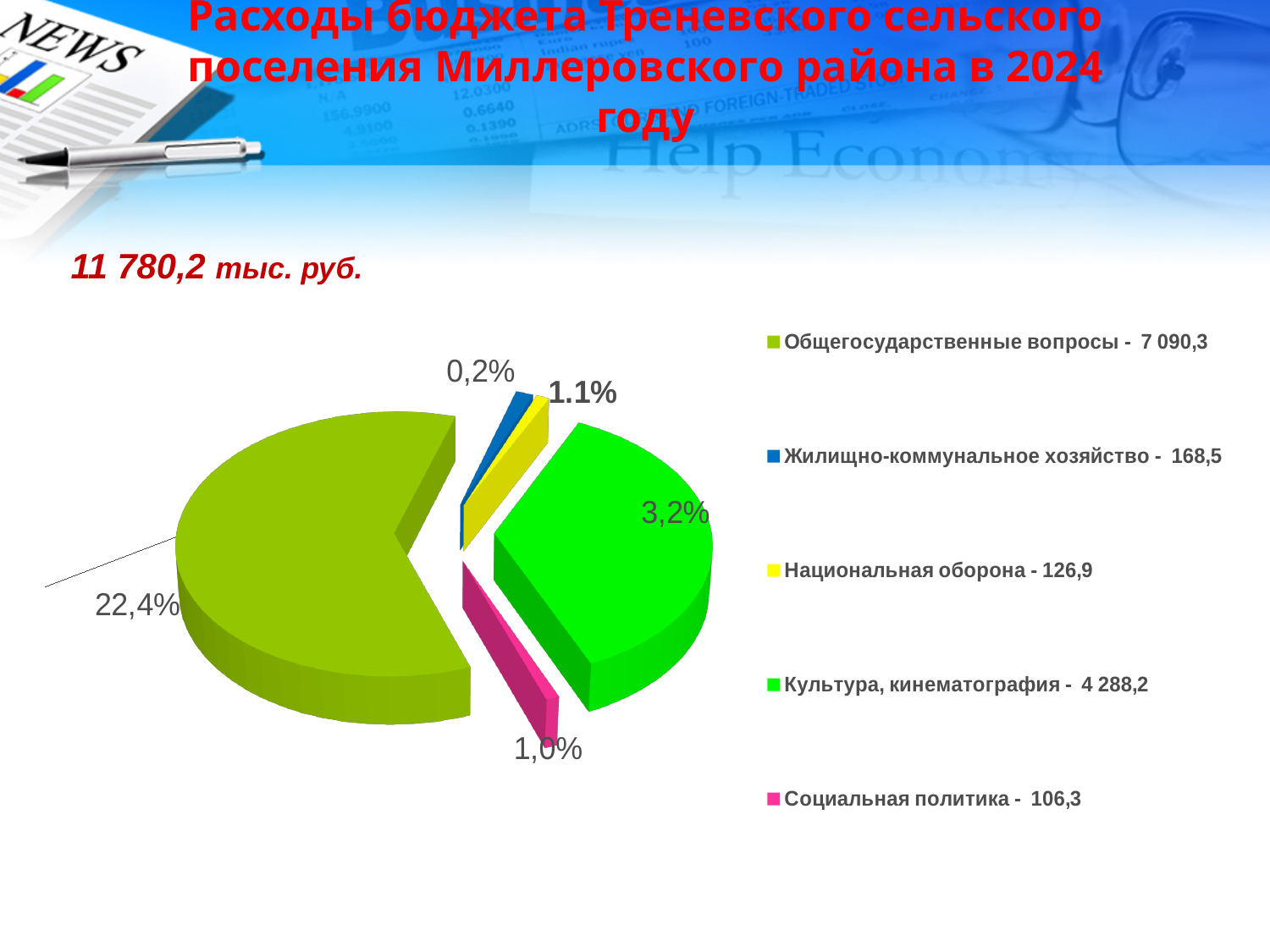
What value is shown in the legend for Культура, кинематография? 4 288,2 How many categories does the legend of the pie chart list? 5 What value is shown in the legend for Социальная политика? 106,3 What value is shown in the legend for Жилищно-коммунальное хозяйство? 168,5 What value is shown in the legend for Общегосударственные вопросы? 7 090,3 Which category has the smallest value in the legend? Социальная политика What total amount of expenditure is printed on the slide above the chart? 11 780,2 тыс. руб. What colour is the slice for Социальная политика? pink What kind of chart is shown on the slide? pie chart What is the difference between the legend values for Общегосударственные вопросы and Культура, кинематография? 2 802,1 Which is larger according to the legend: Национальная оборона or Жилищно-коммунальное хозяйство? Жилищно-коммунальное хозяйство Which category has the largest value in the legend? Общегосударственные вопросы